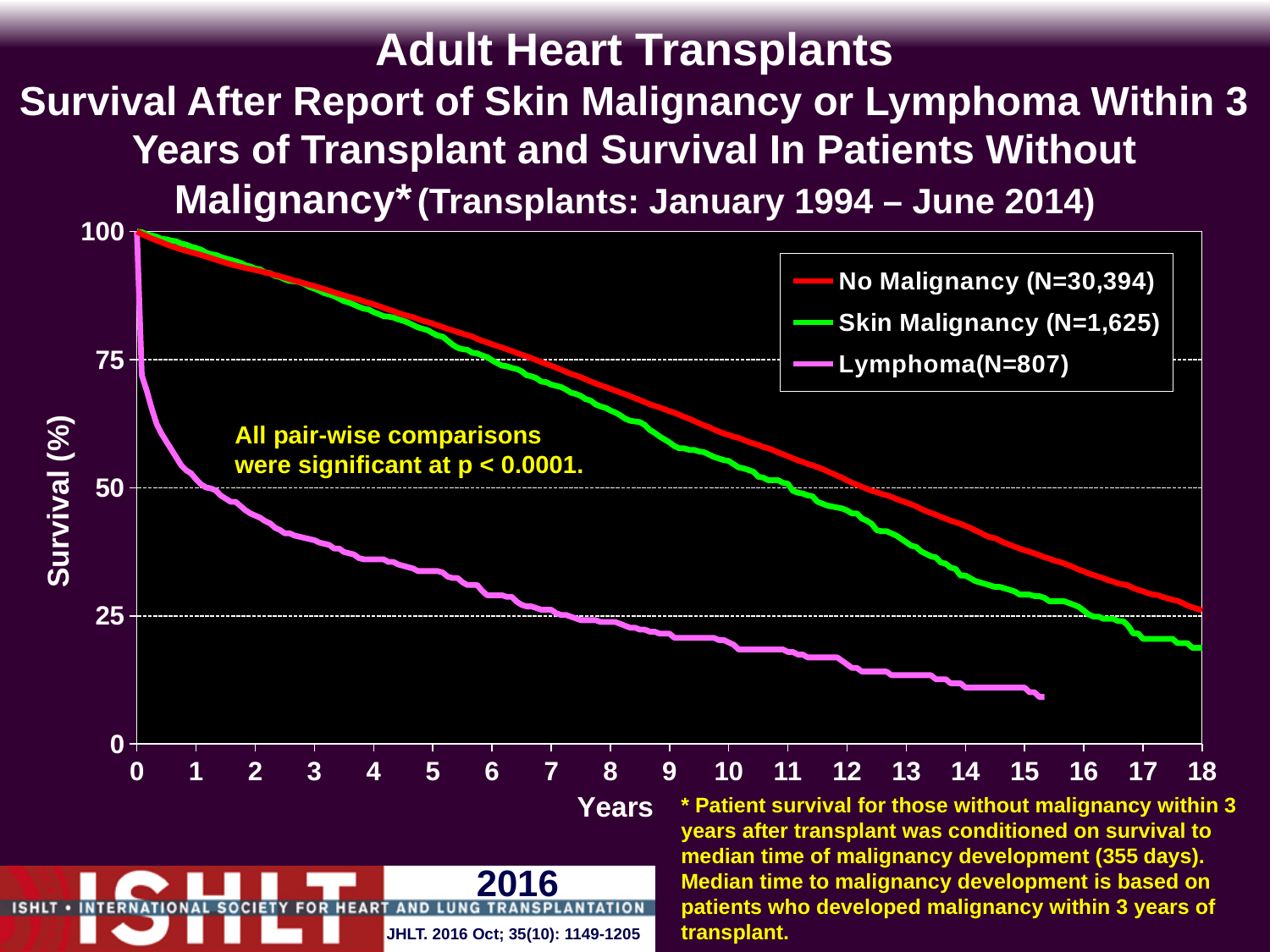
Is the survival for Lymphoma at year 5 greater or less than 50? less What is the N for the No Malignancy group shown in the legend? 30,394 At year 12, which is higher: survival for No Malignancy or for Skin Malignancy? No Malignancy Do the survival curves rise or fall as years since transplant increase? fall At year 10, which is higher: survival for Skin Malignancy or for Lymphoma? Skin Malignancy Which series has the highest survival at year 10? No Malignancy Is the survival for Skin Malignancy at year 8 greater or less than 50? greater What kind of chart is shown on the slide? Line chart How many series does the legend list? 3 What is the N for the Lymphoma group shown in the legend? 807 Which series has the lowest survival across the years shown? Lymphoma Is the survival for No Malignancy at year 10 greater or less than 50? greater